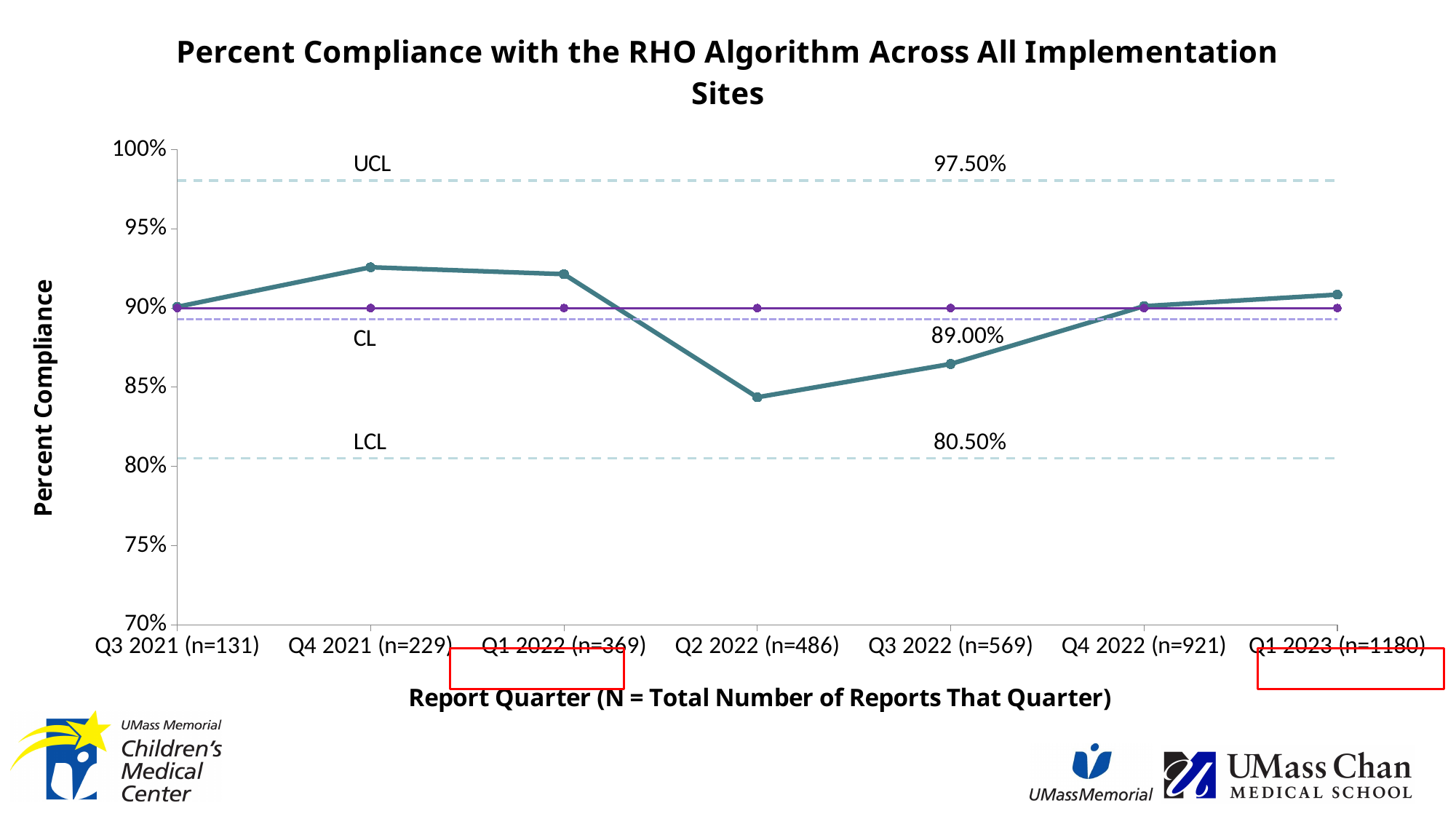
Does percent compliance rise or fall from Q2 2022 to Q1 2023? rise What value is printed for the UCL line? 97.50% How many report quarters are plotted on the x axis? 7 Which report quarter has the lowest percent compliance? Q2 2022 (n=486) What kind of chart is shown on the slide? line chart What value is printed for the LCL line? 80.50% Is the percent compliance for Q3 2022 (n=569) greater or less than 90%? less Which has the higher percent compliance, Q4 2021 (n=229) or Q2 2022 (n=486)? Q4 2021 (n=229) What value is printed for the CL line? 89.00% What is the x-axis label of the chart? Report Quarter (N = Total Number of Reports That Quarter) Is the percent compliance for Q4 2021 (n=229) greater or less than 90%? greater Is the percent compliance for Q2 2022 (n=486) greater or less than 85%? less